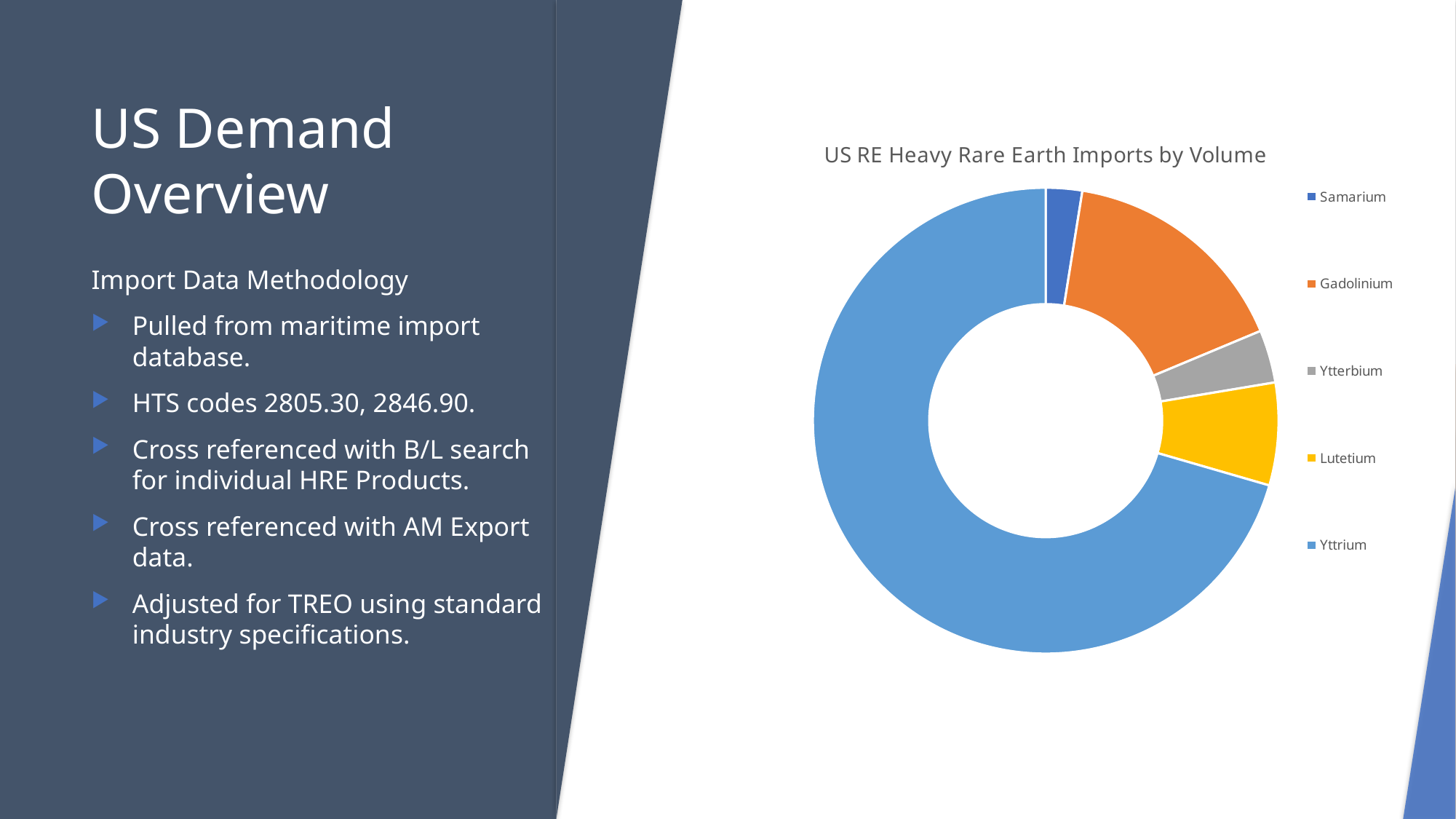
Which category is listed last in the chart's legend? Yttrium Which has the larger share, Lutetium or Ytterbium? Lutetium Which has the larger share, Gadolinium or Lutetium? Gadolinium Is Yttrium's share of the doughnut chart greater or less than half? greater Which has the larger share, Yttrium or Gadolinium? Yttrium Which category is shown in orange in the chart? Gadolinium What is the title of the chart? US RE Heavy Rare Earth Imports by Volume Which category has the smallest share of the doughnut chart? Samarium What type of chart is shown on the slide? Doughnut chart Which category has the largest share of the doughnut chart? Yttrium How many categories does the chart's legend list? 5